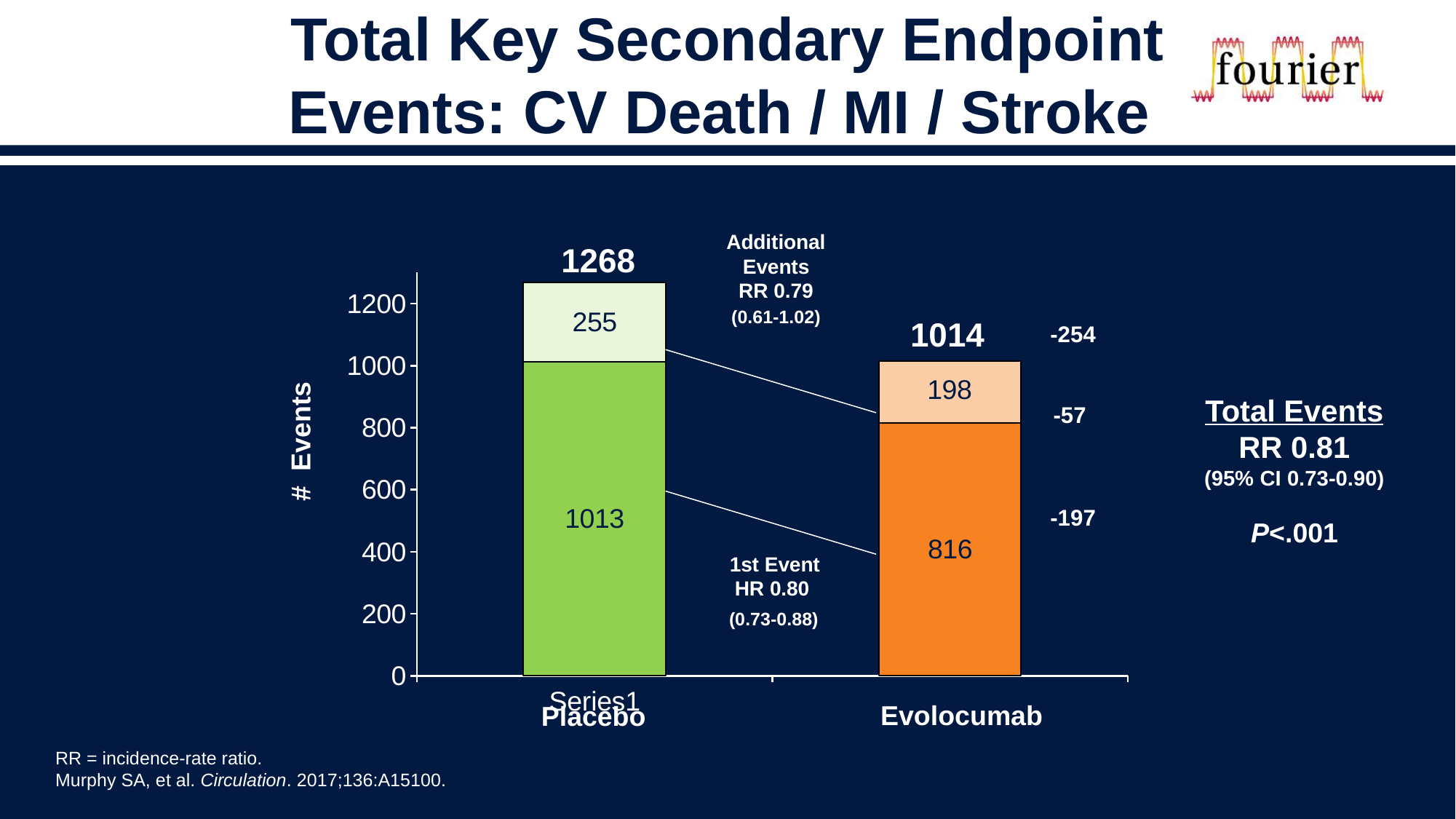
What is the total number of events for the Evolocumab bar? 1014 What is the label of the y-axis? # Events Which group has the higher total number of events? Placebo How many bars (treatment groups) are plotted in the chart? 2 What type of chart is shown on the slide? stacked bar chart What is the number of 1st events (bottom segment) in the Placebo group? 1013 What is the difference in 1st events between the Placebo and Evolocumab groups? 197 What is the total number of events for the Placebo bar? 1268 What is the number of additional events (top segment) in the Placebo group? 255 What is the number of additional events (top segment) in the Evolocumab group? 198 What is the number of 1st events (bottom segment) in the Evolocumab group? 816 What is the difference in total events between the Placebo and Evolocumab groups? 254